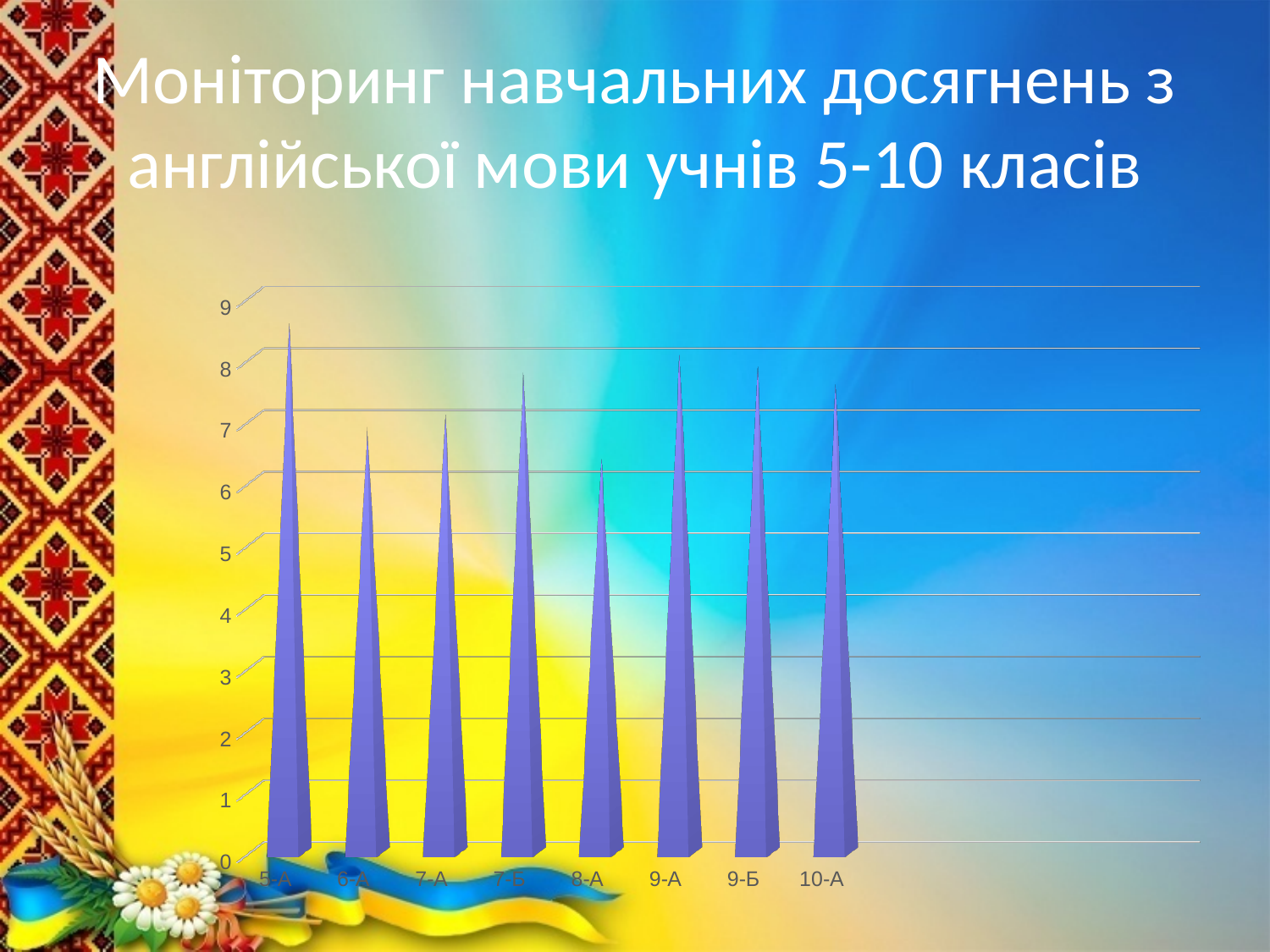
What is the highest value shown on the vertical axis of the chart? 9 Is the value for 5-А greater or less than 8? greater Is the value for 8-А greater or less than 7? less Which is larger, the value for 7-Б or the value for 6-А? 7-Б Is the value for 10-А greater or less than 7? greater What kind of chart is shown on the slide? bar chart Which class has the highest value in the chart? 5-А Which class has the lowest value in the chart? 8-А How many classes are shown on the x axis of the chart? 8 Which is larger, the value for 5-А or the value for 8-А? 5-А